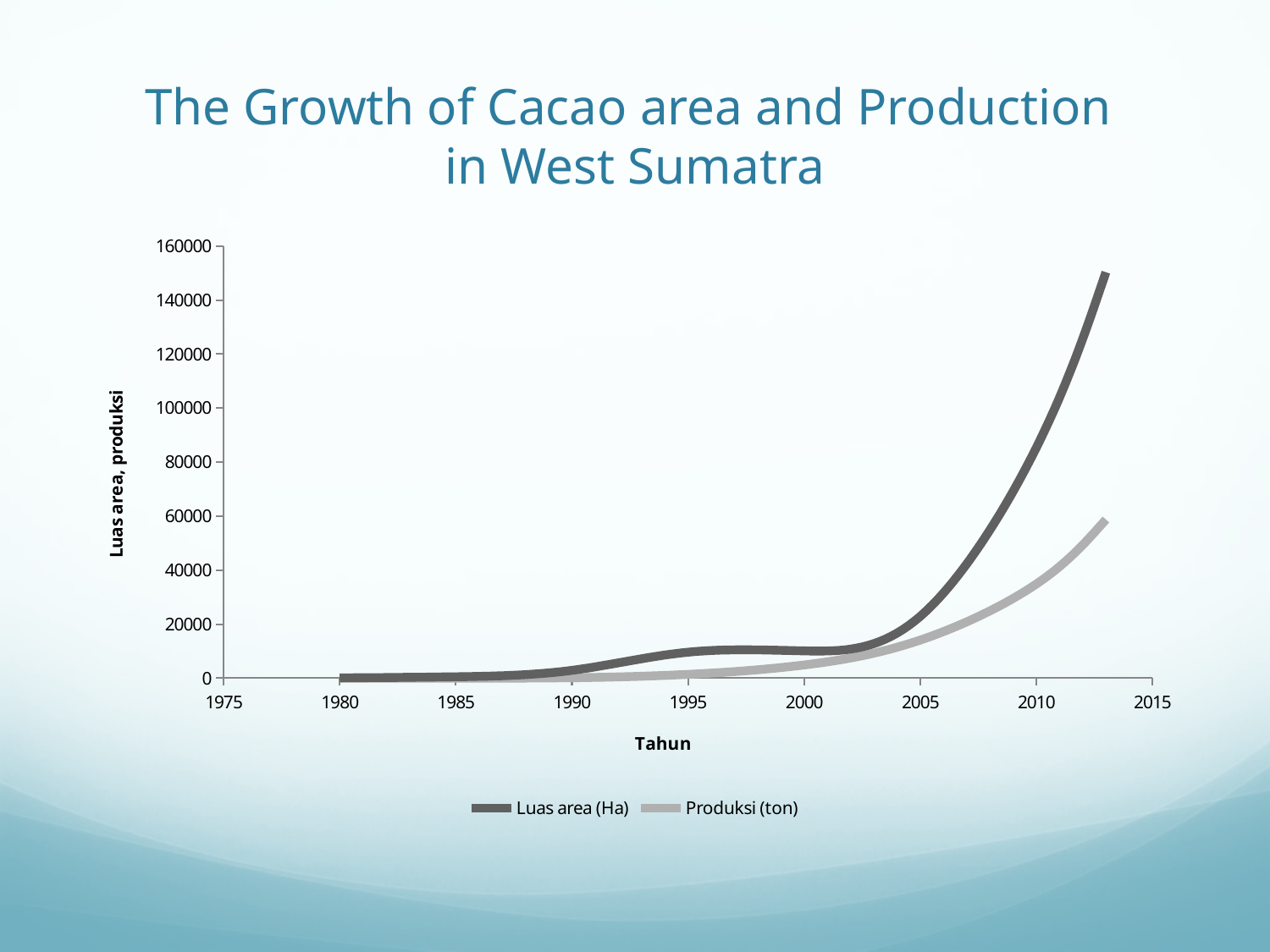
Is the value of Luas area (Ha) in 2005 greater or less than 40000? less How many series does the legend list? 2 Does the Luas area (Ha) line rise or fall between 2005 and 2013? rise Which series reaches the highest value on the chart? Luas area (Ha) Which series has the higher value in 2010, Luas area (Ha) or Produksi (ton)? Luas area (Ha) Is the value of Produksi (ton) in 2000 greater or less than 20000? less What kind of chart is shown on the slide? line chart What are the two series named in the legend? Luas area (Ha) and Produksi (ton) Does the Produksi (ton) line rise or fall between 2000 and 2013? rise Is the value of Produksi (ton) at the end of the line (around 2013) greater or less than 80000? less What is the title of the x axis? Tahun